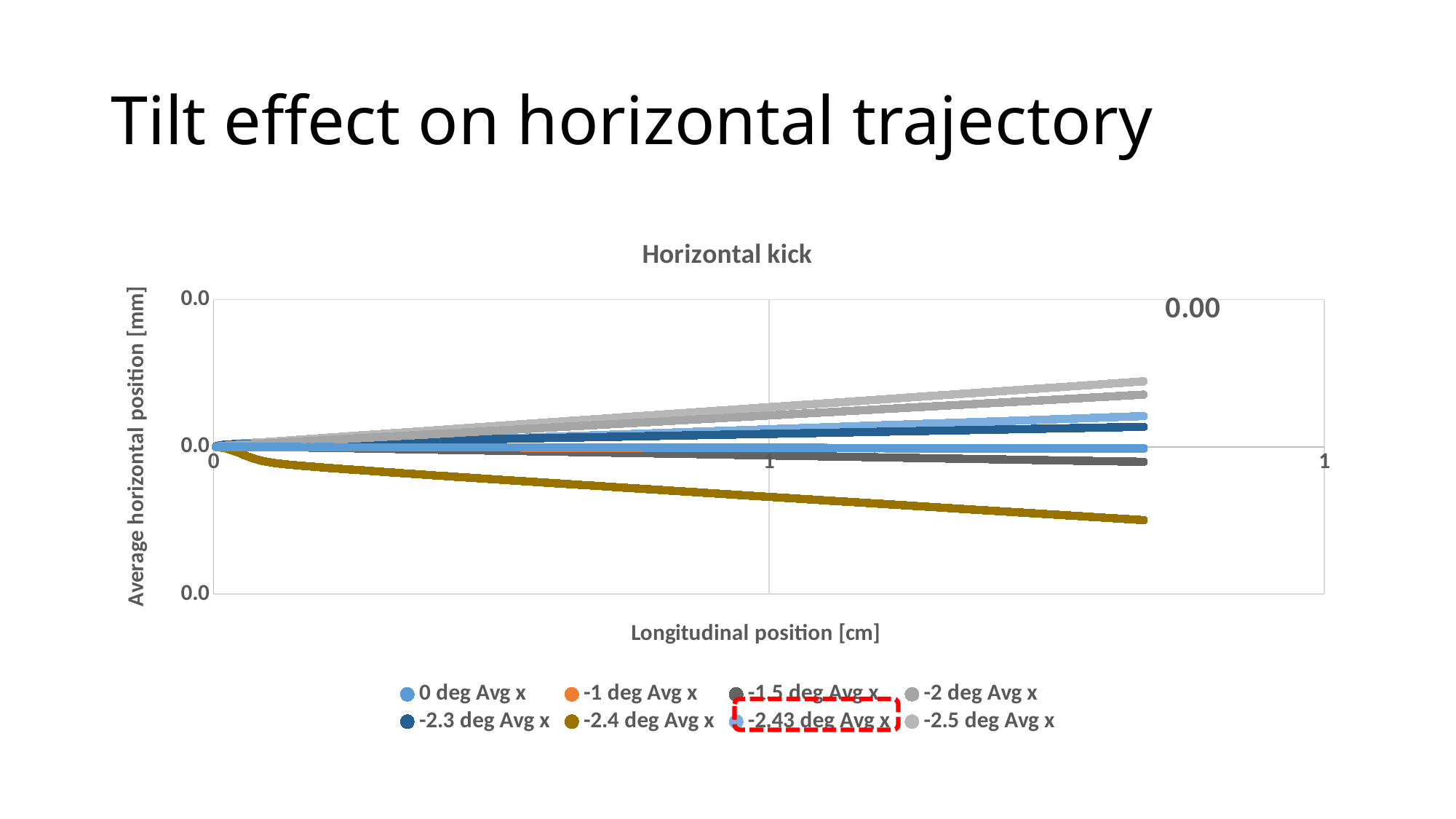
What kind of chart is shown on the slide? Line chart Does the -2.5 deg Avg x series rise or fall as longitudinal position increases? Rise At the right end of the plotted lines, which is larger: the -2 deg Avg x series or the -1.5 deg Avg x series? -2 deg Avg x At the right end of the plotted lines, which is larger: the -2.5 deg Avg x series or the -2.4 deg Avg x series? -2.5 deg Avg x What is the label of the y axis? Average horizontal position [mm] Which series has the highest value at the right end of the plotted lines? -2.5 deg Avg x How many series does the legend list? 8 What is the title of the chart? Horizontal kick Which series has the lowest value at the right end of the plotted lines? -2.4 deg Avg x Does the -2.4 deg Avg x series rise or fall as longitudinal position increases? Fall